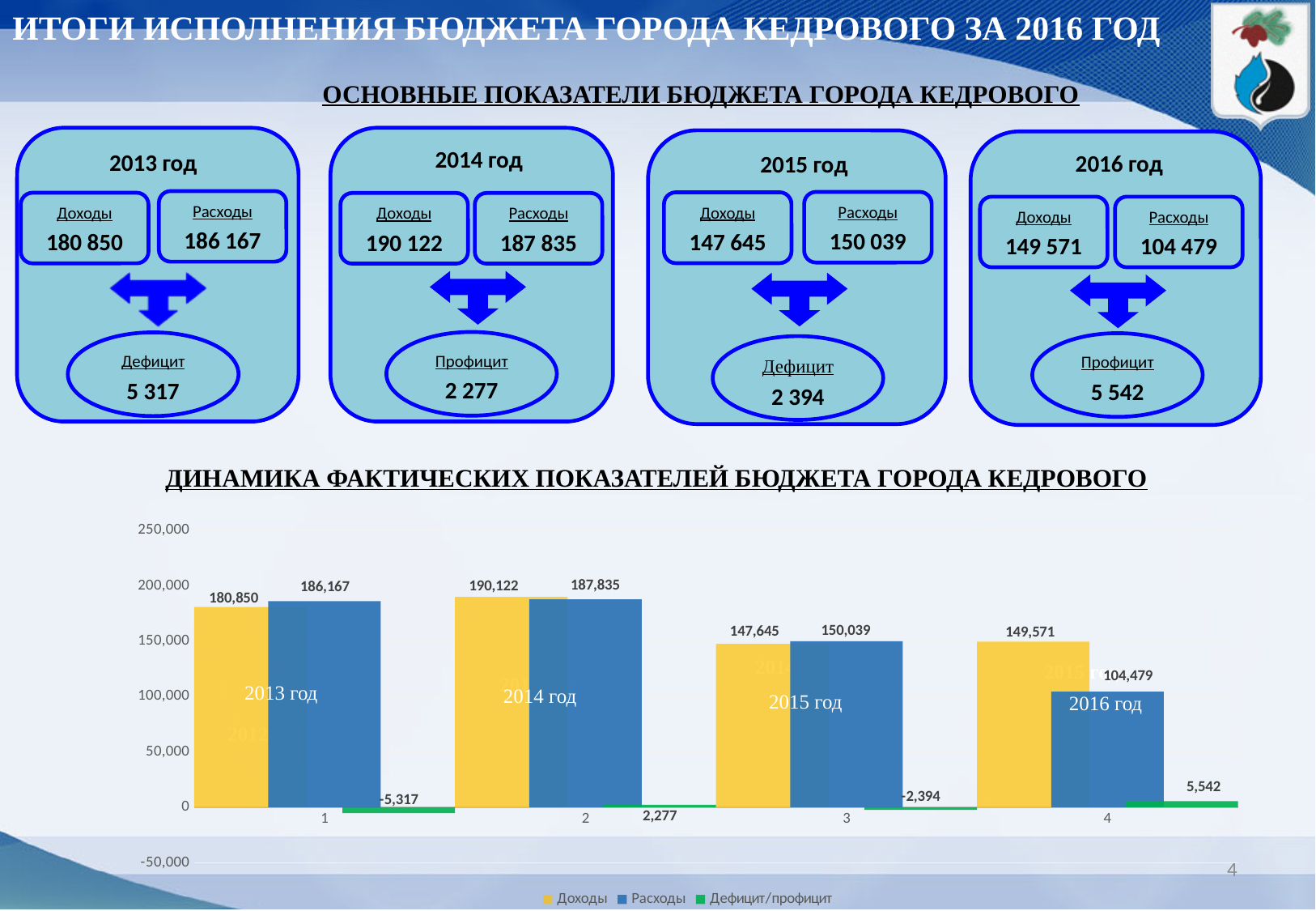
In which year is Расходы lowest in the chart? 2016 год What is the value of Расходы for 2016 год in the chart? 104,479 How many years (categories) are plotted in the chart? 4 What is the difference between Доходы and Расходы for 2015 год in the chart? 2,394 What is the value of Доходы for 2013 год in the chart? 180,850 How many series does the legend of the chart list? 3 What kind of chart is shown under the heading 'ДИНАМИКА ФАКТИЧЕСКИХ ПОКАЗАТЕЛЕЙ БЮДЖЕТА ГОРОДА КЕДРОВОГО'? bar chart What is the value of Дефицит/профицит for 2014 год in the chart? 2,277 Which colour represents Дефицит/профицит in the chart legend? green In which year is Доходы highest in the chart? 2014 год Which is larger in the chart for 2016 год: Доходы or Расходы? Доходы Is the value of Расходы for 2016 год greater or less than 150,000? less